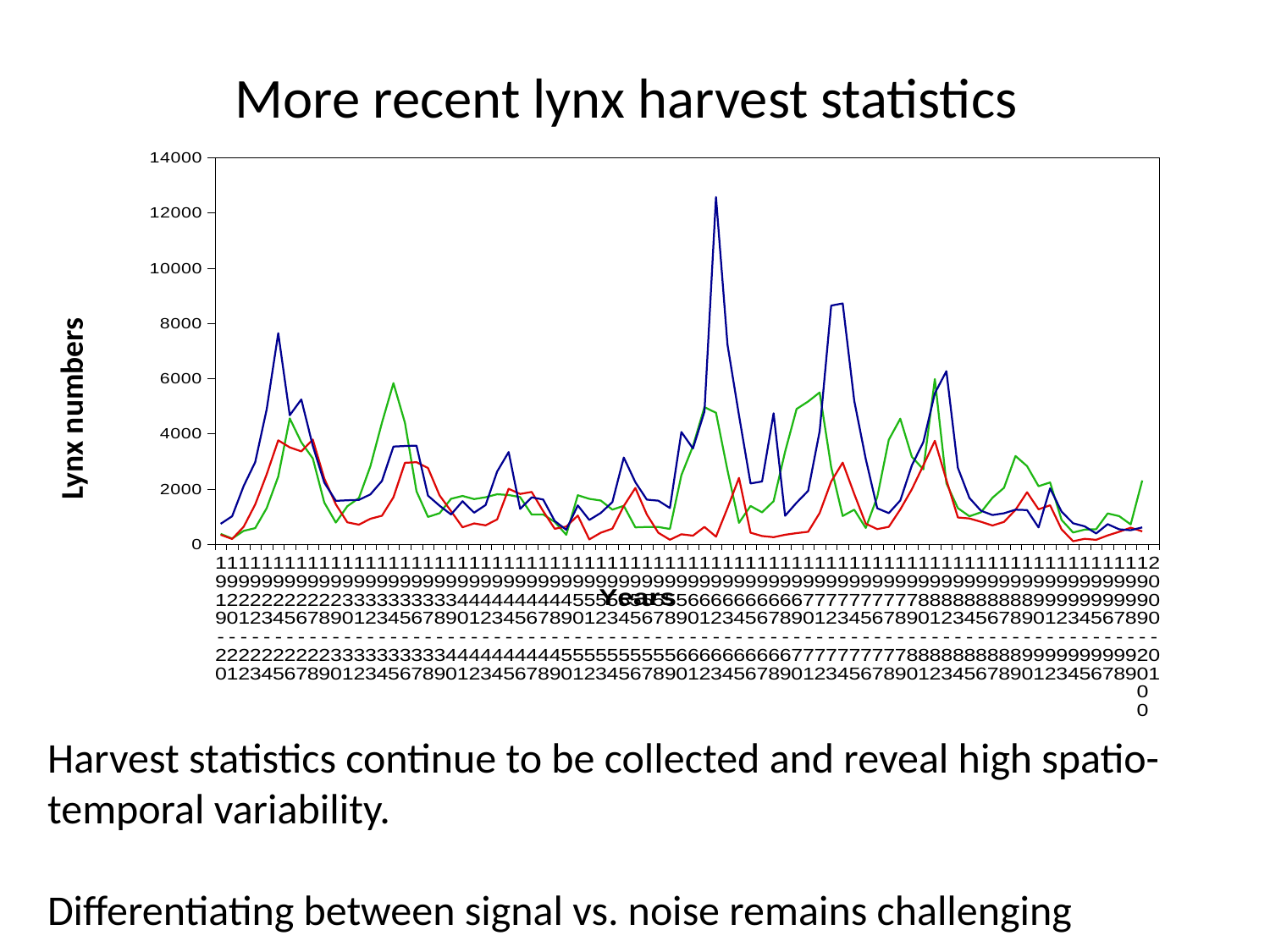
Is the highest peak of the blue line greater or less than 12000? greater How many lines are plotted on the chart? 3 Is the highest peak of the green line greater or less than 4000? greater Which line reaches a higher peak, the blue line or the red line? blue What is the highest value shown on the vertical axis? 14000 Which coloured line reaches the highest value on the chart? blue Is the highest peak of the red line greater or less than 6000? less What kind of chart is shown on the slide? line chart What is the title of the chart? More recent lynx harvest statistics What is the label on the vertical axis of the chart? Lynx numbers